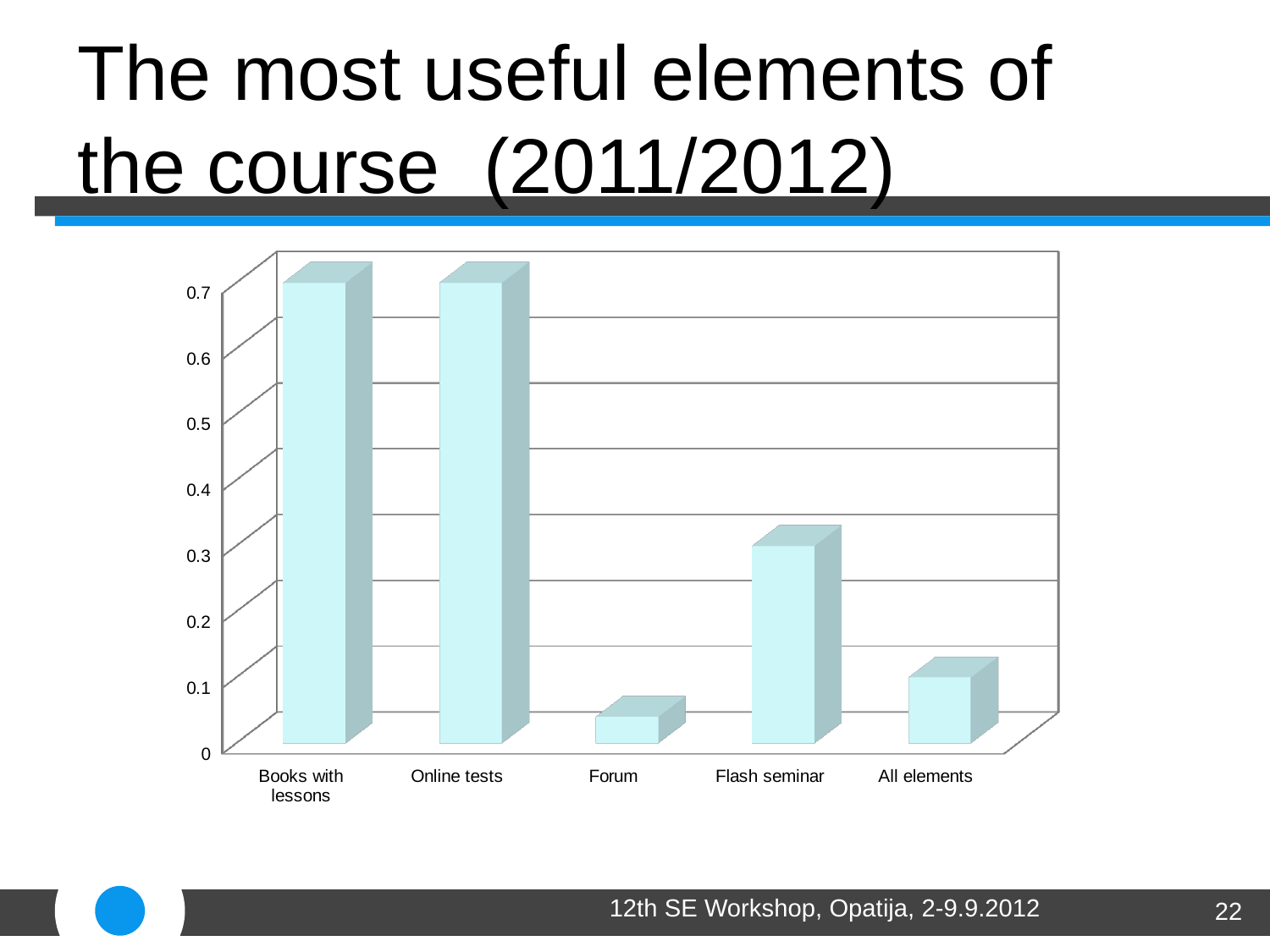
Is the value for Books with lessons greater or less than 0.6? greater What kind of chart is shown on the slide? bar chart Is the value for Flash seminar greater or less than 0.2? greater Is the value for Online tests greater or less than 0.5? greater Which has a larger value, Flash seminar or All elements? Flash seminar Which has a larger value, Forum or All elements? All elements Which course element has the lowest value in the chart? Forum What is the title of the slide containing the chart? The most useful elements of the course (2011/2012) How many course elements are shown on the x axis of the chart? 5